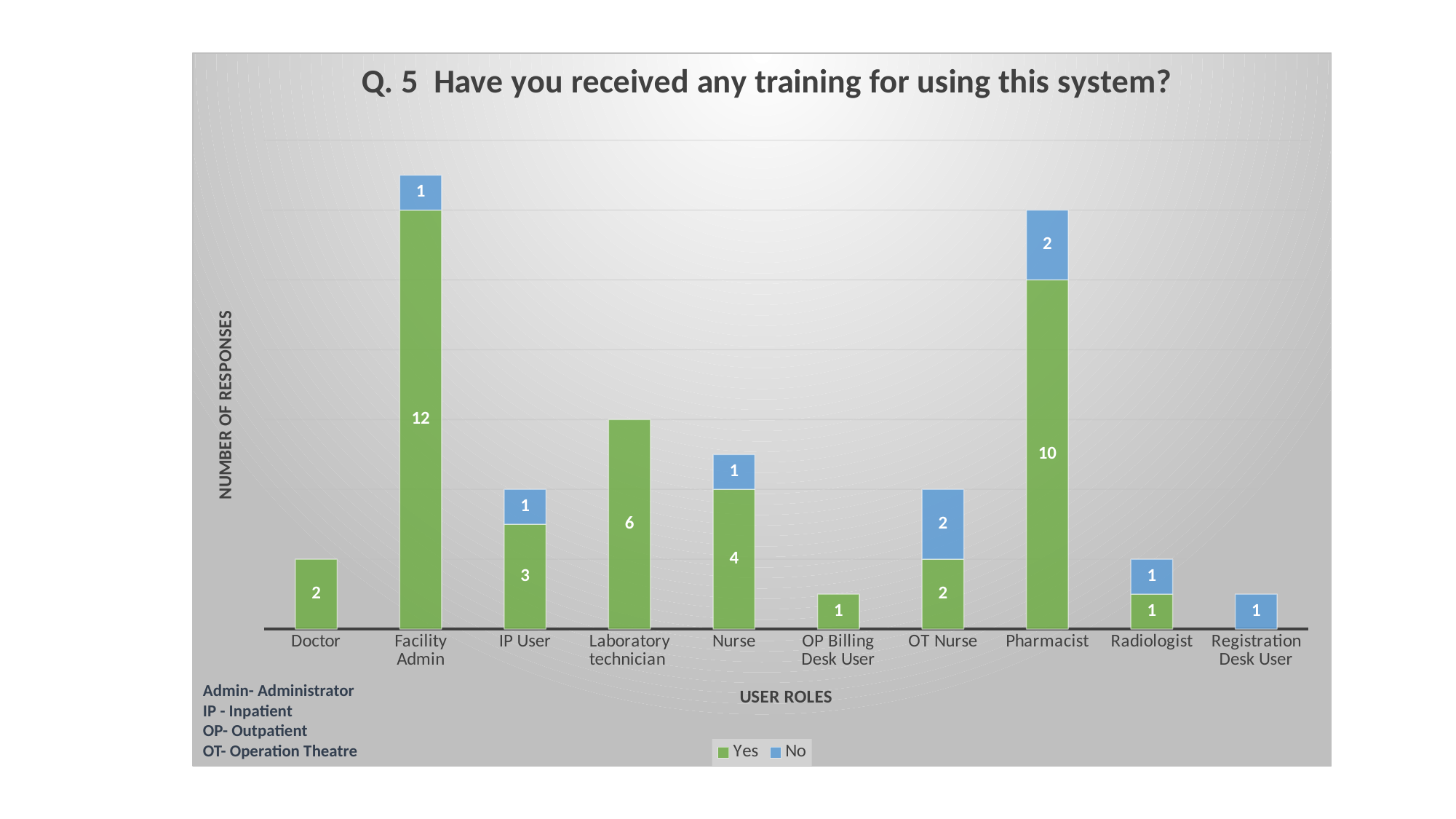
What is the 'No' value for Pharmacist? 2 Which is larger, the 'Yes' value for Laboratory technician or the 'Yes' value for IP User? Laboratory technician What is the total of the stacked bar for Pharmacist? 12 How many series does the legend list? 2 What is the title of the chart? Q. 5 Have you received any training for using this system? What kind of chart is shown on the slide? Stacked bar chart Which user role has the highest 'Yes' value? Facility Admin What is the 'Yes' value for Facility Admin? 12 How many user roles are shown on the x axis? 10 What is the 'Yes' value for Nurse? 4 What is the difference between the 'Yes' values for Facility Admin and Pharmacist? 2 What is the total of the stacked bar for OT Nurse? 4